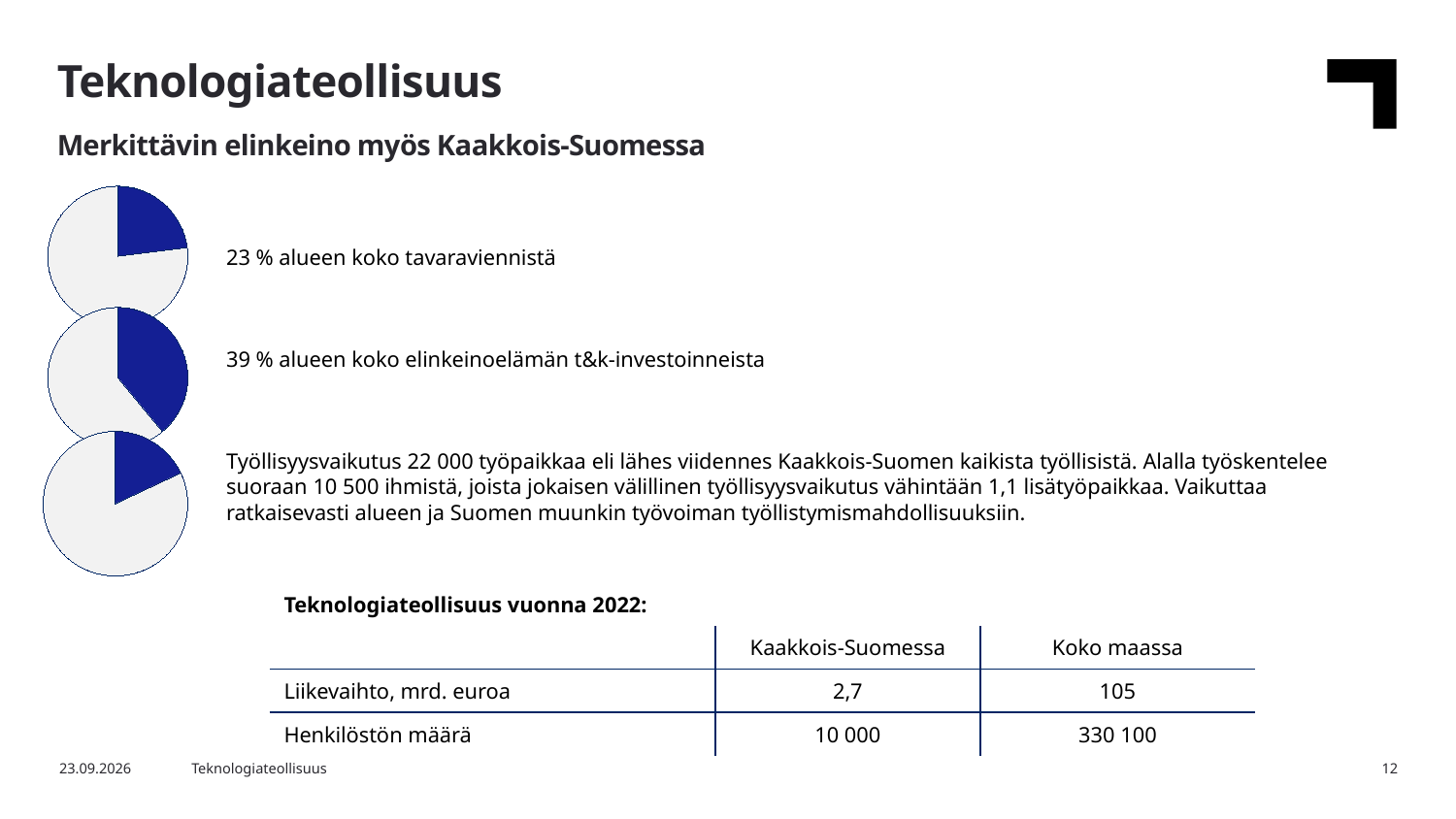
What is the main title of the slide containing the pie charts? Teknologiateollisuus What colour is the highlighted slice in each pie chart? Dark blue Which pie chart has the larger highlighted slice, the middle one (t&k-investoinnit) or the bottom one (työllisyysvaikutus)? The middle one (t&k-investoinnit) According to the text next to the top pie chart, what share of the region's total goods exports (tavaravienti) does the highlighted slice represent? 23 % How many slices does each pie chart have? 2 Which pie chart has the larger highlighted slice, the top one (tavaravienti) or the middle one (t&k-investoinnit)? The middle one (t&k-investoinnit) Which of the three pie charts has the largest highlighted slice? The middle one (39 % of t&k-investoinnit) How many pie charts are on the slide? 3 What kind of charts are shown on the left side of the slide? Pie charts According to the text next to the middle pie chart, what share of the region's business R&D investments (t&k-investoinnit) does the highlighted slice represent? 39 %